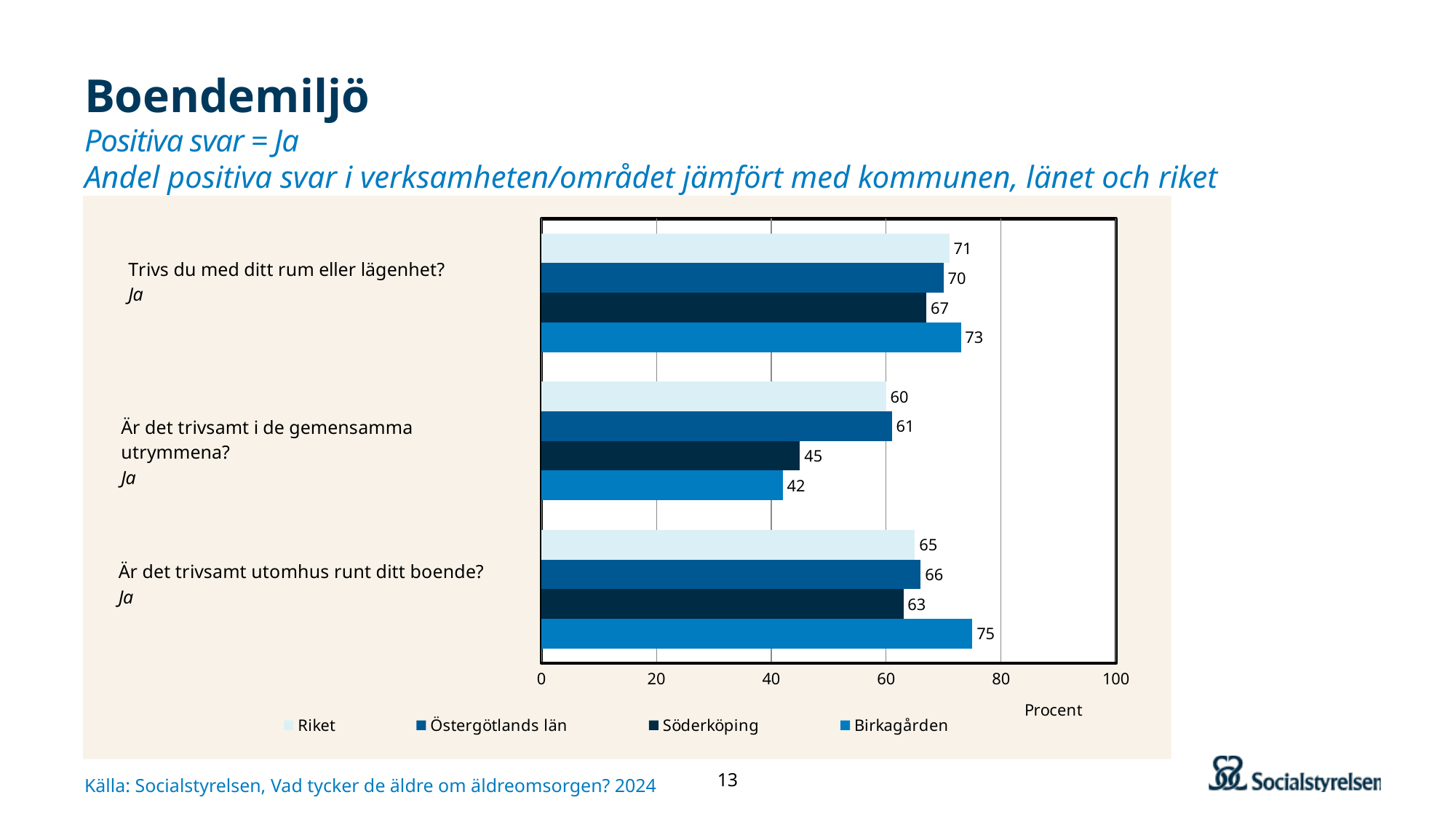
Is the value for Birkagården on "Är det trivsamt i de gemensamma utrymmena?" greater or less than 60? less How many series does the legend list? 4 What kind of chart is shown on the slide? bar chart Which series has the highest value on "Är det trivsamt utomhus runt ditt boende?"? Birkagården What is the value for Söderköping on "Är det trivsamt i de gemensamma utrymmena?"? 45 How many questions (categories) are shown on the chart? 3 What is the value for Östergötlands län on "Är det trivsamt i de gemensamma utrymmena?"? 61 Which series has the lowest value on "Är det trivsamt i de gemensamma utrymmena?"? Birkagården What is the difference between Birkagården and Söderköping on "Är det trivsamt utomhus runt ditt boende?"? 12 What is the value for Riket on "Är det trivsamt utomhus runt ditt boende?"? 65 Which is larger on "Trivs du med ditt rum eller lägenhet?": Riket or Söderköping? Riket What is the value for Birkagården on "Trivs du med ditt rum eller lägenhet?"? 73